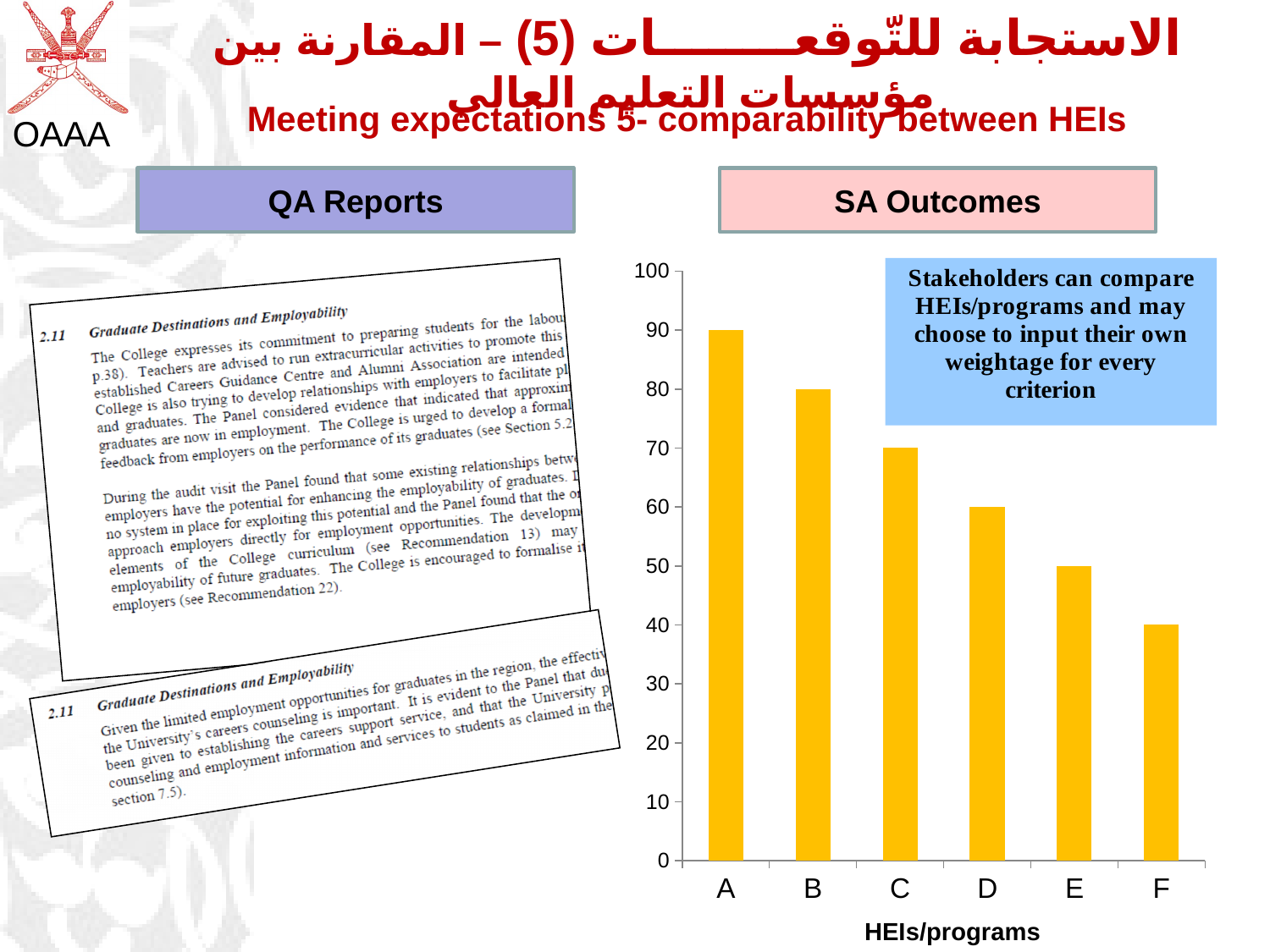
Which HEI/program has the lowest value on the bar chart? F What type of chart is shown under SA Outcomes? bar chart What is the x-axis title of the bar chart? HEIs/programs What is the value for F on the bar chart? 40 What is the value for D on the bar chart? 60 Which HEI/program has the highest value on the bar chart? A How many HEIs/programs are plotted on the bar chart? 6 What is the difference between the values for A and F on the bar chart? 50 What is the value for A on the bar chart? 90 Which is larger on the bar chart, the value for B or the value for E? B Do the values on the bar chart rise or fall from A to F? fall Is the value for C on the bar chart greater or less than 60? greater